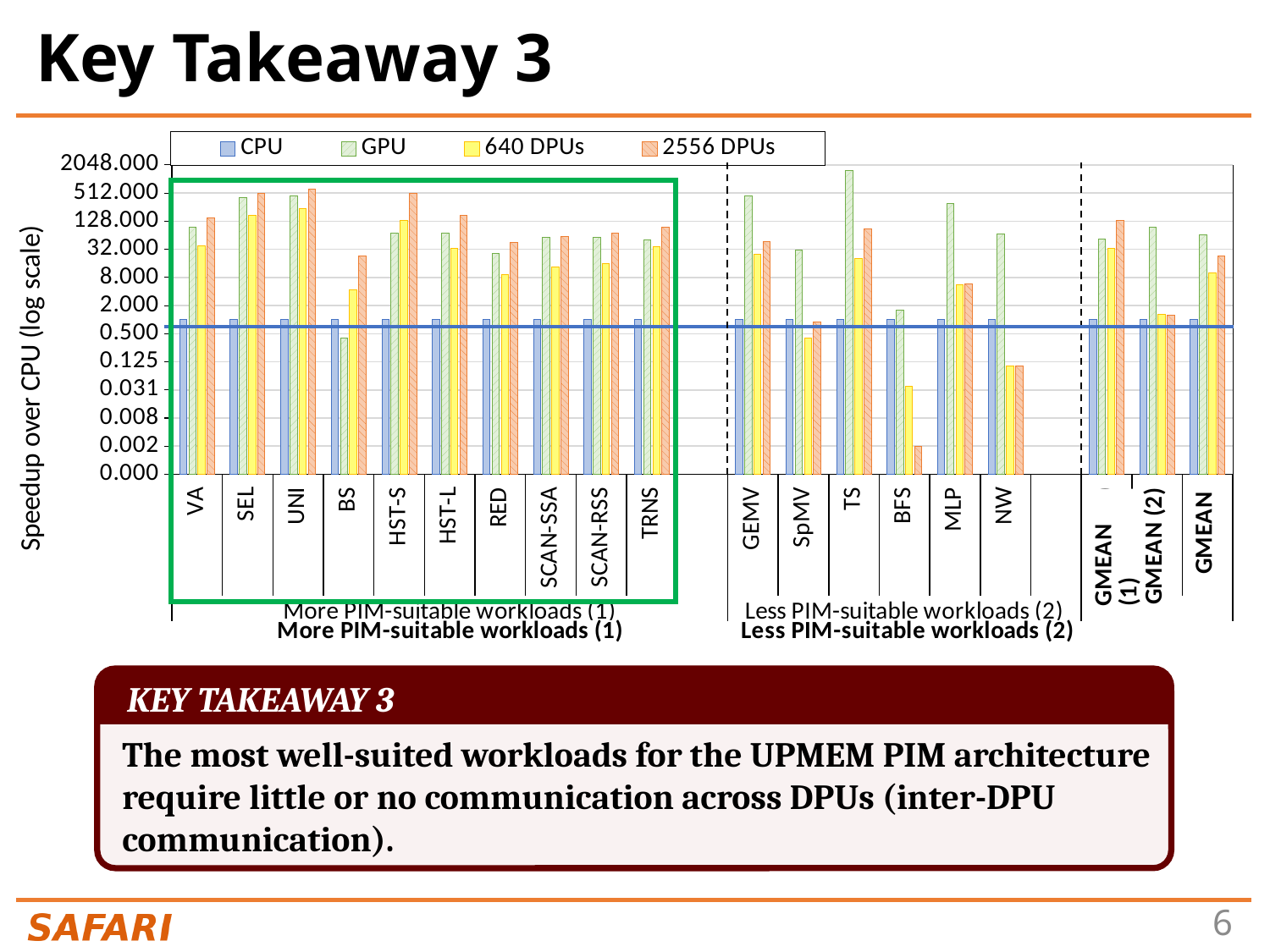
Which series has the highest bar for TS? GPU Which workload has the lowest 2556 DPUs bar? BFS What kind of chart is shown on the slide? bar chart Is the 2556 DPUs value for SEL greater or less than 128? greater Is the GPU value for TS greater or less than 512? greater Is the 2556 DPUs value for BFS greater or less than 0.008? less How many workload categories (including the GMEAN entries) are shown along the x axis? 19 For BS, which is larger: the GPU value or the 2556 DPUs value? 2556 DPUs How many series does the chart legend list? 4 What is the label of the y axis? Speedup over CPU (log scale)